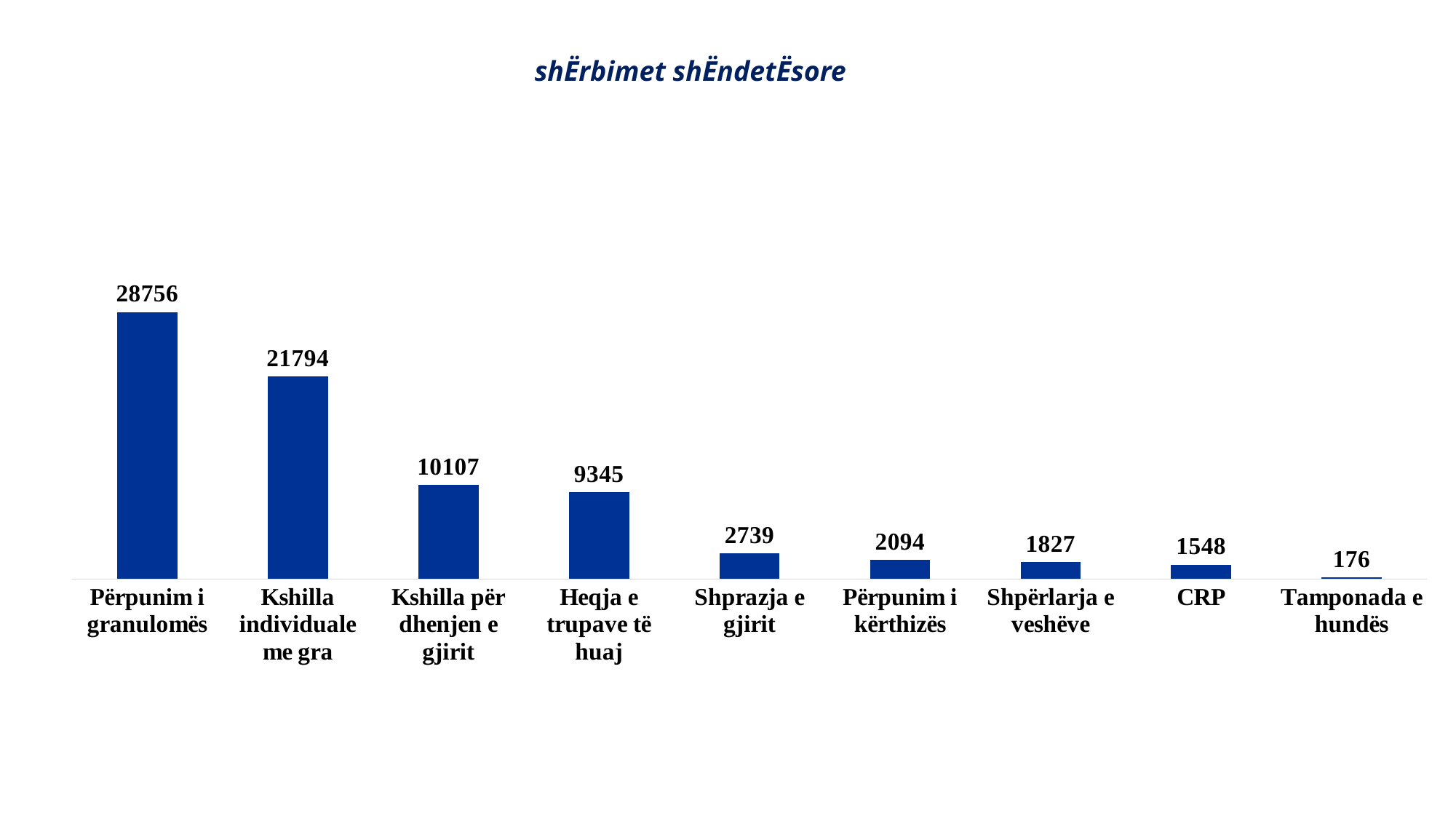
What is the value for Përpunim i granulomës? 28756 Do the values rise or fall from left to right along the x axis? Fall What is the value for CRP? 1548 Which category has the lowest value? Tamponada e hundës What is the difference between Kshilla për dhenjen e gjirit and Heqja e trupave të huaj? 762 What is the difference between Përpunim i granulomës and Kshilla individuale me gra? 6962 Which is larger, Shprazja e gjirit or Përpunim i kërthizës? Shprazja e gjirit Which category has the highest value? Përpunim i granulomës What is the title of the chart? shËrbimet shËndetËsore How many categories are shown in the chart? 9 What kind of chart is shown on the slide? Bar chart What is the value for Heqja e trupave të huaj? 9345